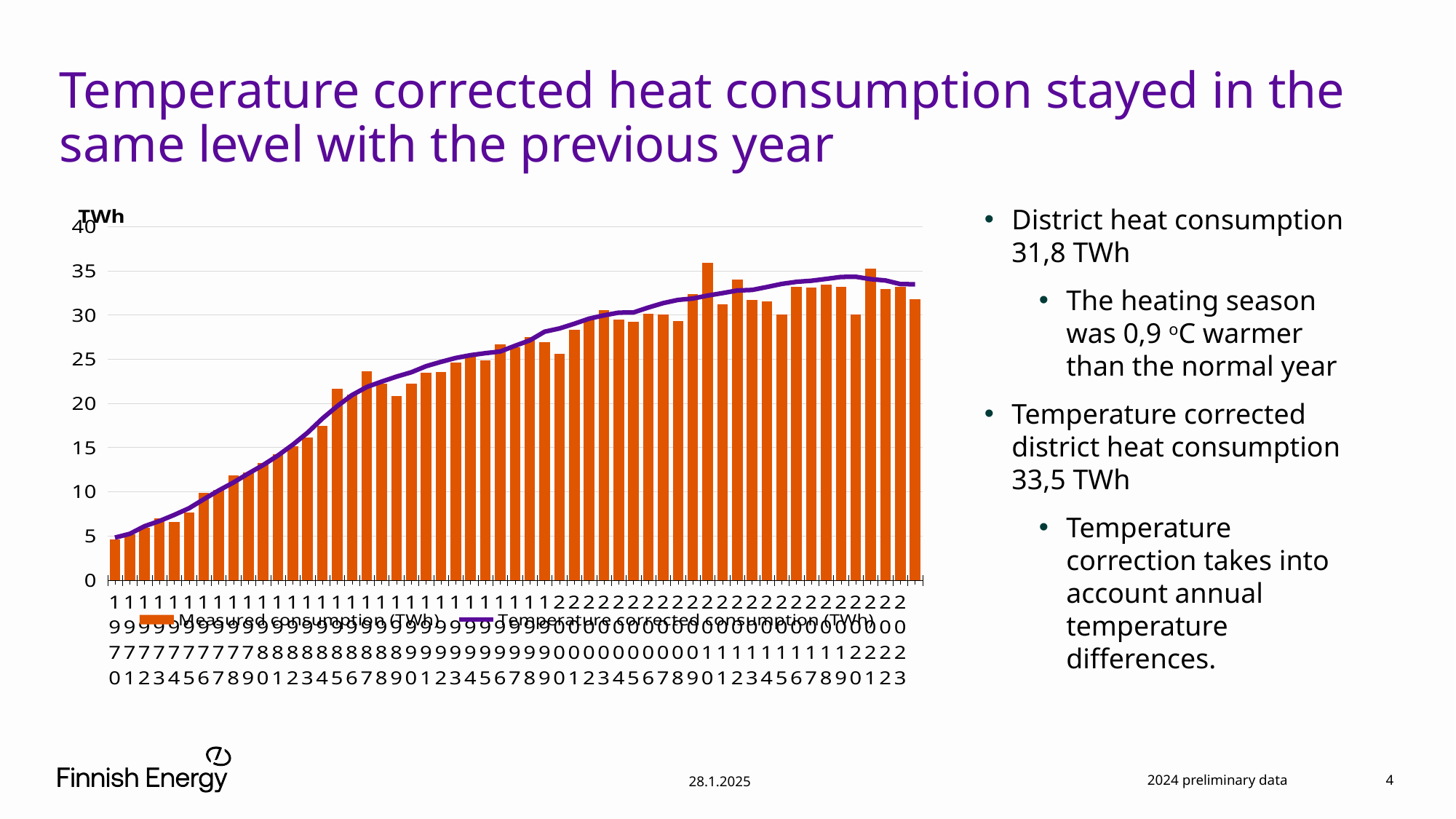
How many series does the chart legend list? 2 What kind of chart is shown on the slide? A bar chart combined with a line chart What unit is shown as the label of the vertical axis? TWh Is the measured consumption bar for 2010 greater or less than 35? greater Is the measured consumption bar for 2000 greater or less than 30? less Which year has the highest bar for measured consumption? 2010 What are the two series named in the chart legend? Measured consumption (TWh) and Temperature corrected consumption (TWh) Which year has the larger measured consumption bar, 2010 or 2023? 2010 Is the measured consumption bar for 1990 greater or less than 20? greater Does the temperature corrected consumption line generally rise or fall from 1970 to 2023? Rise Which year has the lowest bar for measured consumption? 1970